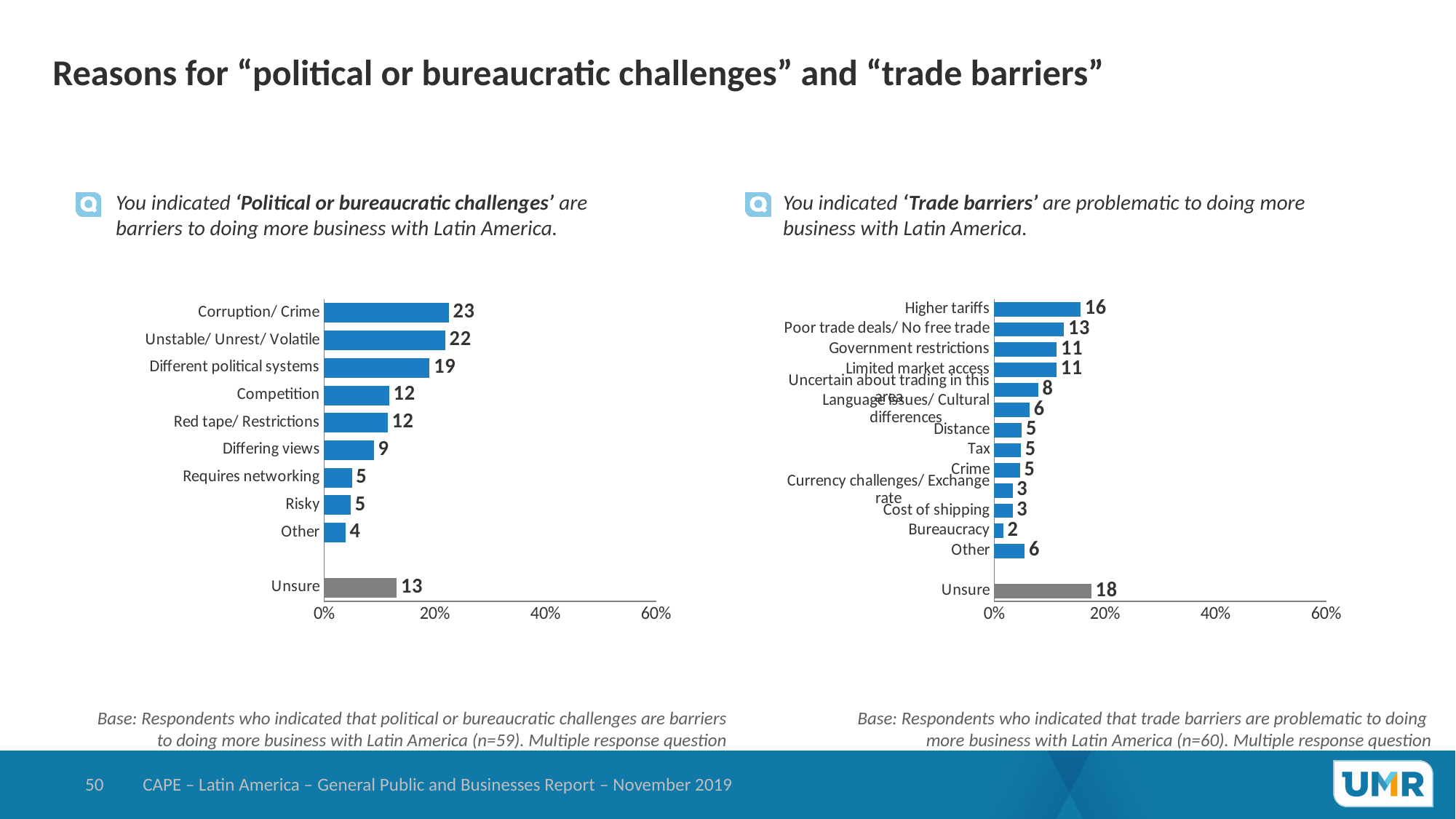
In the 'Political or bureaucratic challenges' chart on the left, what is the value for Corruption/ Crime? 23 What type of chart is used on the left side of the slide? Bar chart In the 'Political or bureaucratic challenges' chart on the left, which category has the highest value? Corruption/ Crime In the 'Trade barriers' chart on the right, what is the value for Higher tariffs? 16 In the 'Trade barriers' chart on the right, which category has the lowest value? Bureaucracy In the 'Trade barriers' chart on the right, is the value for Higher tariffs greater or less than 20%? less In the 'Trade barriers' chart on the right, what is the value for Bureaucracy? 2 In the 'Political or bureaucratic challenges' chart on the left, how many categories are plotted, including Unsure? 10 In the 'Political or bureaucratic challenges' chart on the left, what is the difference between Corruption/ Crime and Different political systems? 4 In the 'Trade barriers' chart on the right, which is larger: Poor trade deals/ No free trade or Government restrictions? Poor trade deals/ No free trade In the 'Political or bureaucratic challenges' chart on the left, what is the value for Differing views? 9 In the 'Trade barriers' chart on the right, what is the difference between Unsure and Higher tariffs? 2